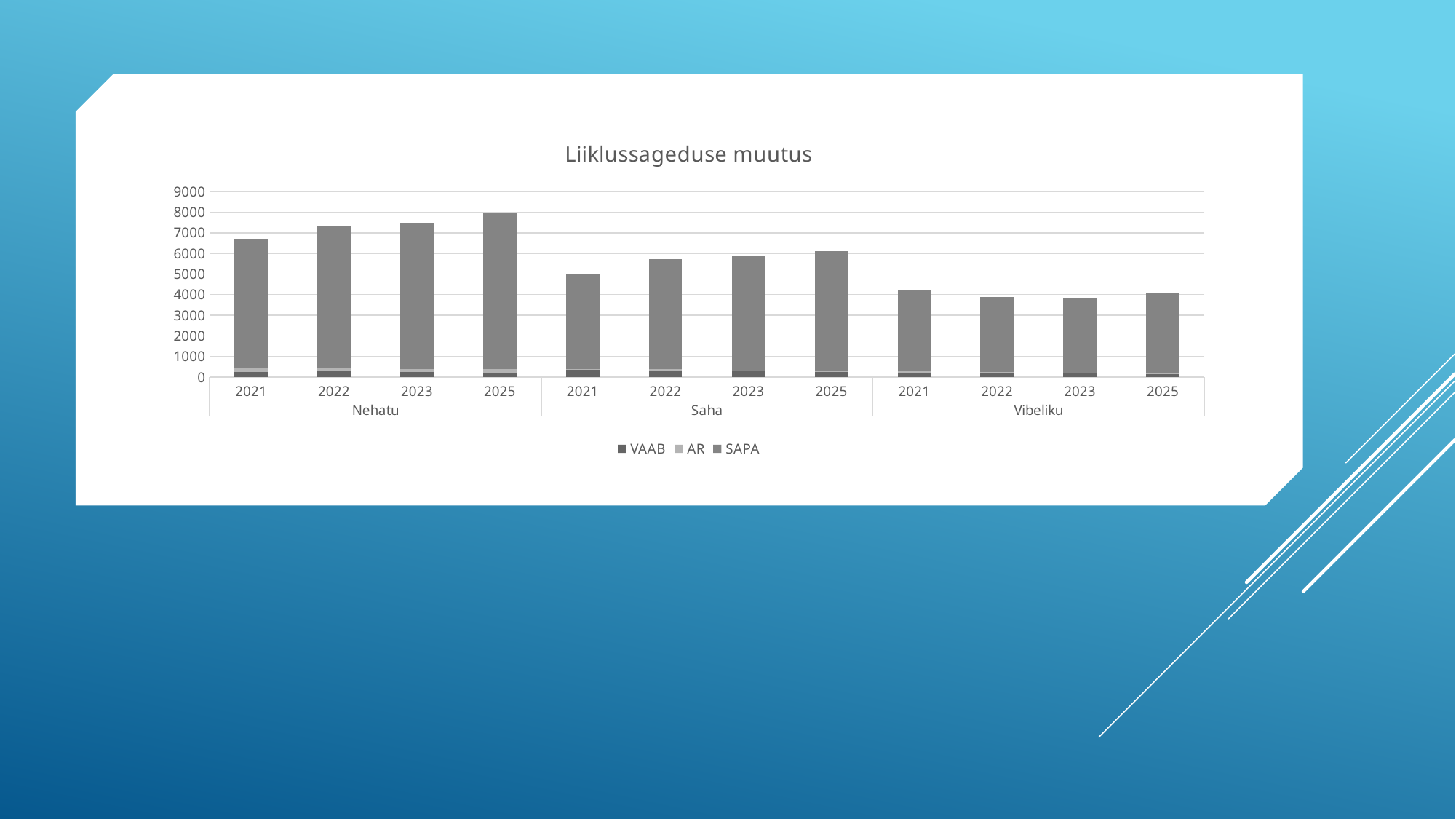
Do the totals for Nehatu rise or fall from 2021 to 2025? rise How many bars are plotted in the chart? 12 Is the total for Vibeliku 2021 greater or less than 5000? less What kind of chart is shown on the slide? Stacked bar chart Which bar is the tallest in the chart? Nehatu 2025 Is the total for Saha 2022 greater or less than 5000? greater Is the total for Nehatu 2023 greater or less than 8000? less Which is larger, the total for Nehatu 2021 or the total for Saha 2021? Nehatu 2021 What is the title of the chart? Liiklussageduse muutus How many series does the legend list? 3 Which series are listed in the legend? VAAB, AR, SAPA